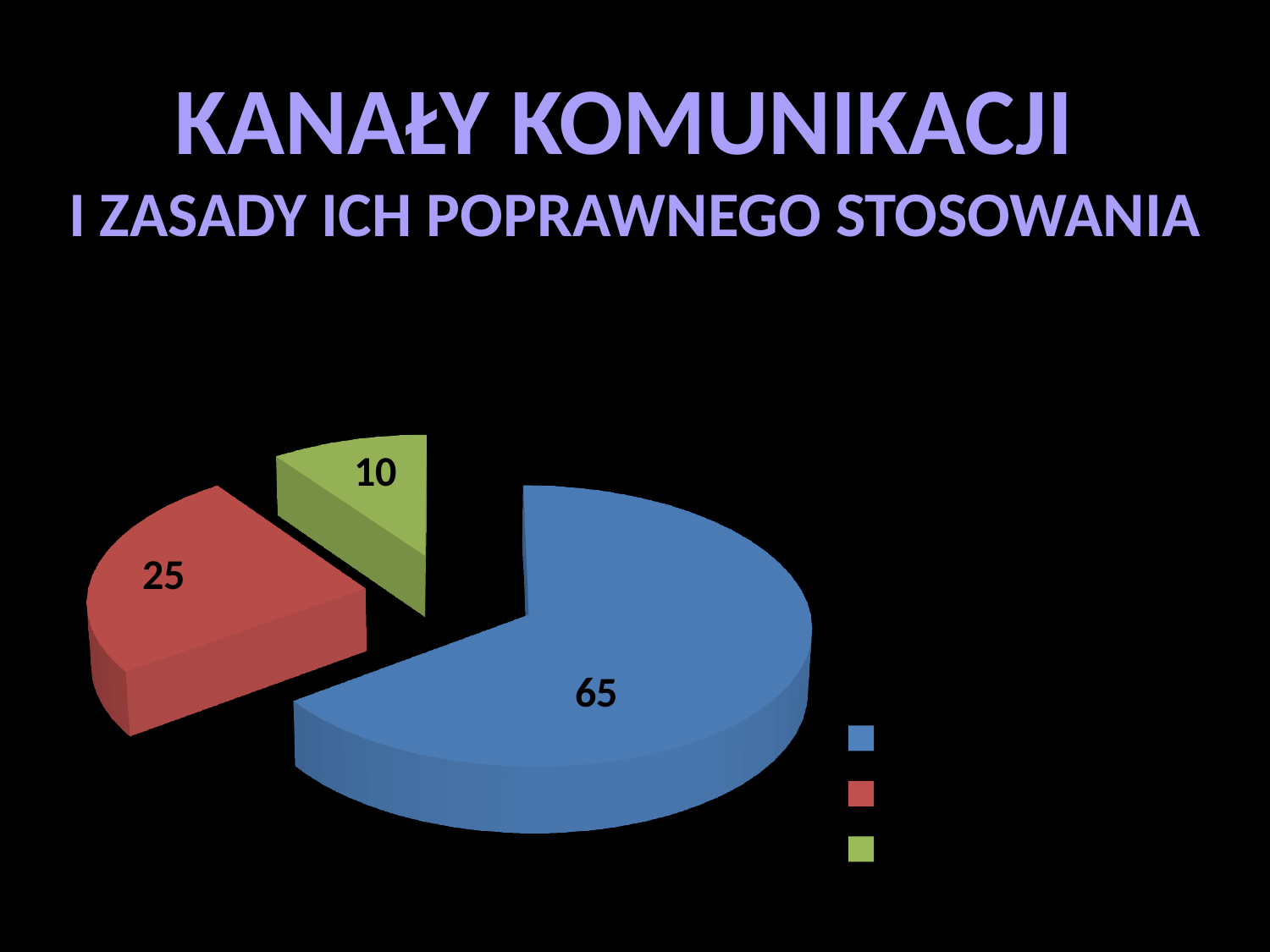
Which slice of the pie chart has the largest value? the blue slice (65) What value is printed on the blue slice of the pie chart? 65 How many slices does the pie chart have? 3 What is the difference between the values of the blue slice and the red slice? 40 Which is larger, the value of the red slice or the green slice? the red slice What share of the pie does the blue slice represent? 65% What kind of chart is shown on the slide? pie chart What value is printed on the green slice of the pie chart? 10 Which slice of the pie chart has the smallest value? the green slice (10) What value is printed on the red slice of the pie chart? 25 What is the difference between the values of the red slice and the green slice? 15 What is the total of all the values shown on the pie chart? 100